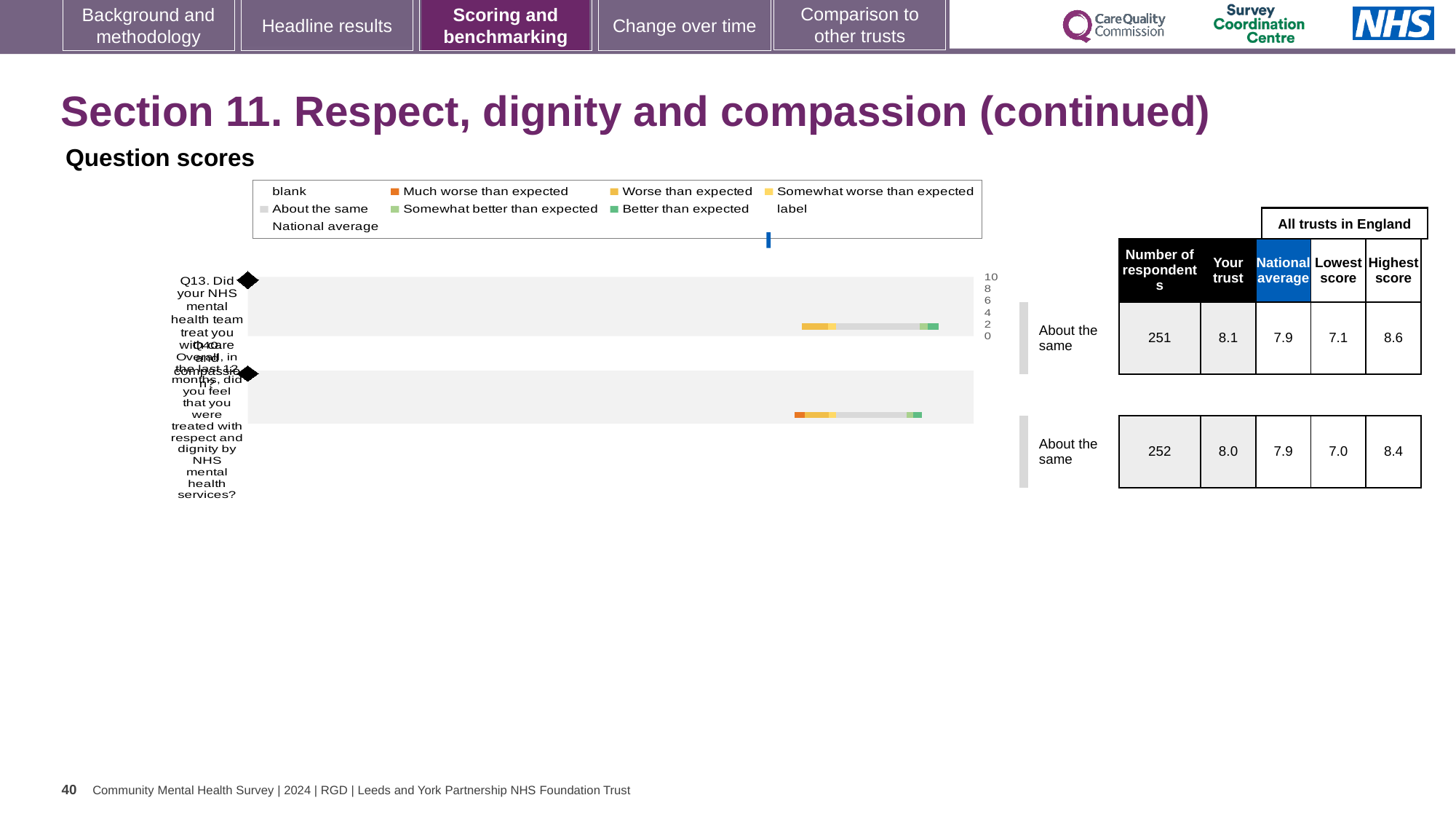
What is the lowest score among all trusts in England for Q14? 7.0 What is the number of respondents for Q14? 252 What is the national average score for Q13? 7.9 How is the trust's score for Q13 categorised relative to expectations? About the same How many questions are plotted in the question scores chart? 2 What is the highest score among all trusts in England for Q13? 8.6 What is the 'Your trust' score for Q14? 8.0 Which question has the higher 'Your trust' score, Q13 or Q14? Q13 What is the difference between the highest and lowest scores for Q14? 1.4 Which colour in the legend represents 'Much worse than expected'? orange What kind of chart is used to show the question scores? bar chart What is the 'Your trust' score for Q13? 8.1